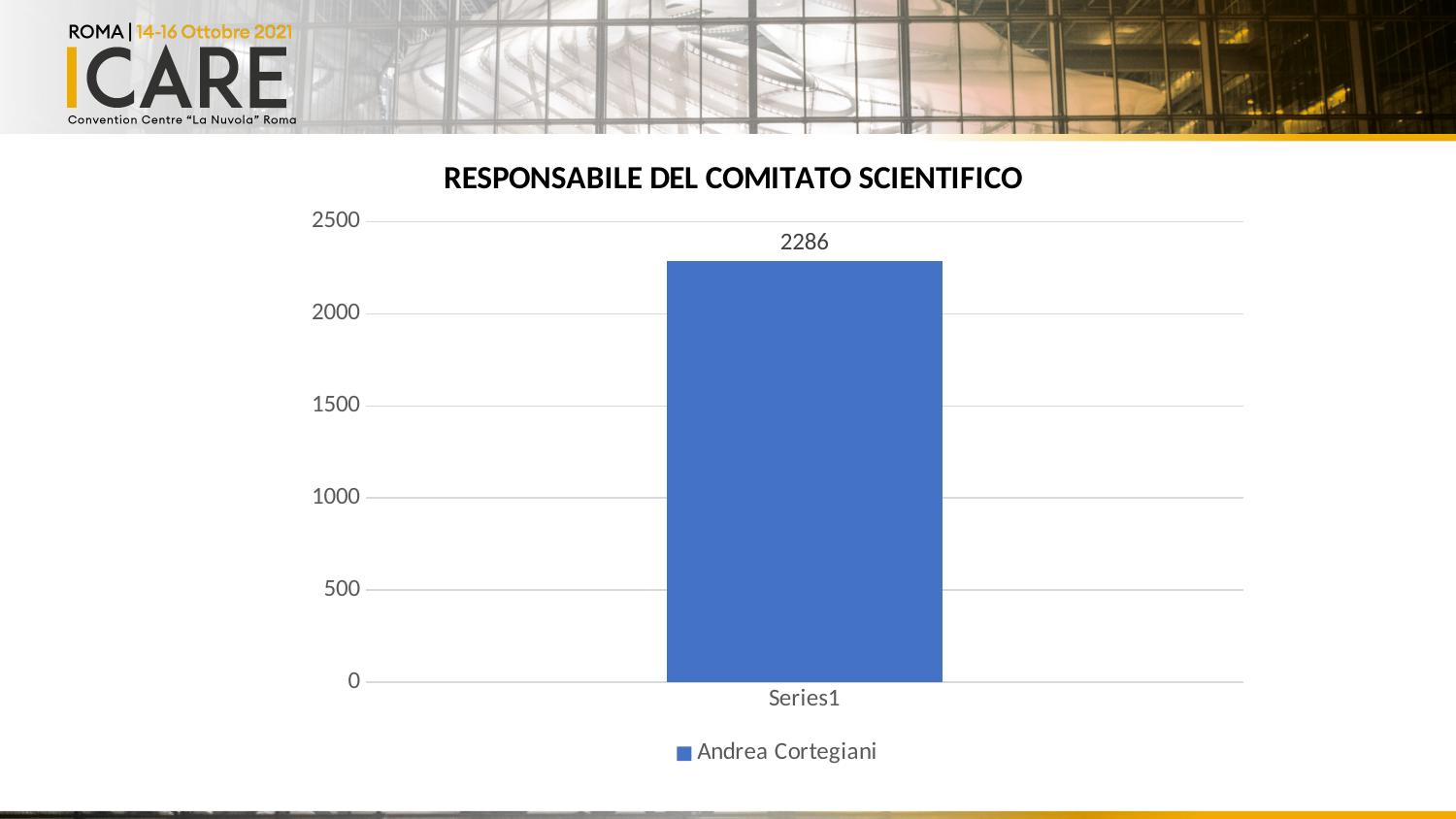
Is the value for Andrea Cortegiani greater or less than 2500? less What is the category label shown on the x axis? Series1 What type of chart is shown on the slide? bar chart How many bars are plotted in the chart? 1 What is the name of the series listed in the legend? Andrea Cortegiani What is the value shown for Andrea Cortegiani in the chart? 2286 What is the highest value shown on the y axis? 2500 Is the value for Andrea Cortegiani greater or less than 2000? greater What is the title of the chart? RESPONSABILE DEL COMITATO SCIENTIFICO How many series does the legend list? 1